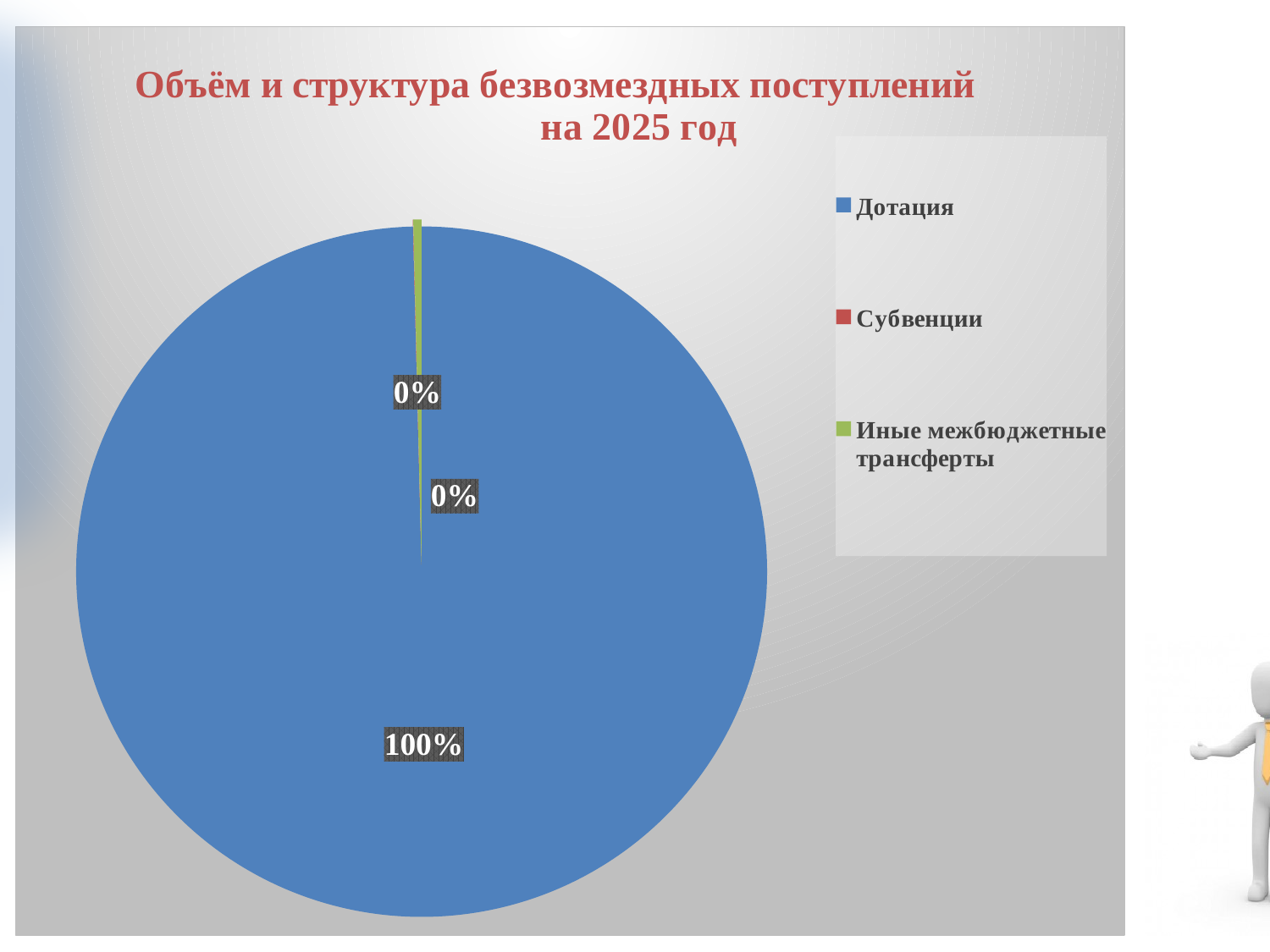
What is the difference between the share for Дотация and the share for Субвенции? 100% How many categories does the legend list? 3 What share of the pie does Дотация account for? 100% What share of the pie does Иные межбюджетные трансферты account for? 0% How many slices are labelled in the pie chart? 3 What kind of chart is shown on the slide? pie chart What is the title of the chart? Объём и структура безвозмездных поступлений на 2025 год Which category has the largest share of the pie? Дотация Which is larger, the share for Дотация or the share for Иные межбюджетные трансферты? Дотация What colour represents Дотация in the chart? blue What share of the pie does Субвенции account for? 0%